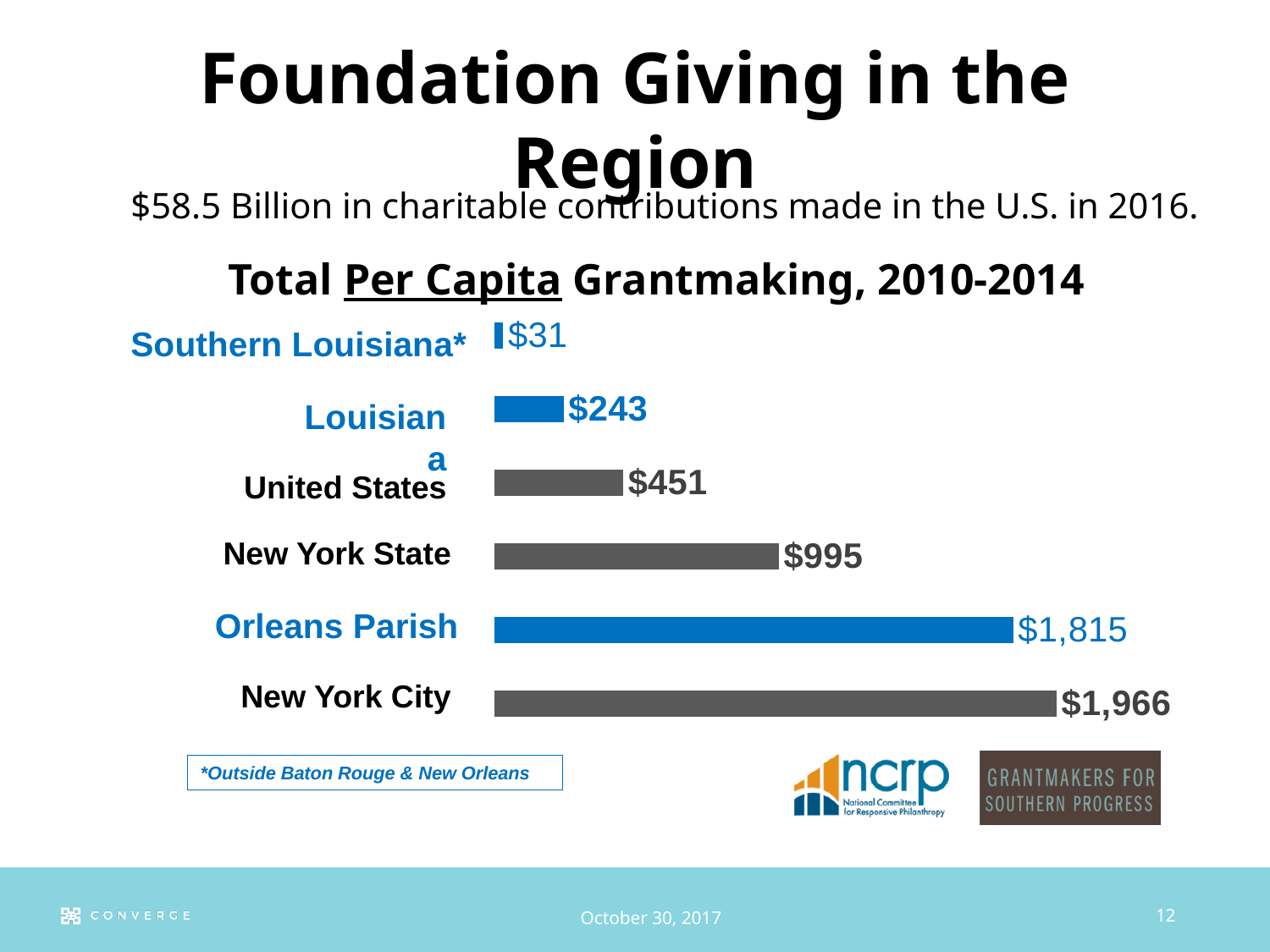
Which category has the highest total per capita grantmaking? New York City What is the total per capita grantmaking value for the United States? $451 Which has a larger per capita grantmaking value, Louisiana or the United States? United States What is the title of the chart? Total Per Capita Grantmaking, 2010-2014 What is the total per capita grantmaking value for Southern Louisiana*? $31 What kind of chart is shown on the slide? Bar chart What is the difference between the per capita grantmaking values for New York State and the United States? $544 What is the total per capita grantmaking value for New York State? $995 What is the total per capita grantmaking value for Orleans Parish? $1,815 How many categories are shown in the chart? 6 What is the difference between the per capita grantmaking values for New York City and Orleans Parish? $151 Which category has the lowest total per capita grantmaking? Southern Louisiana*